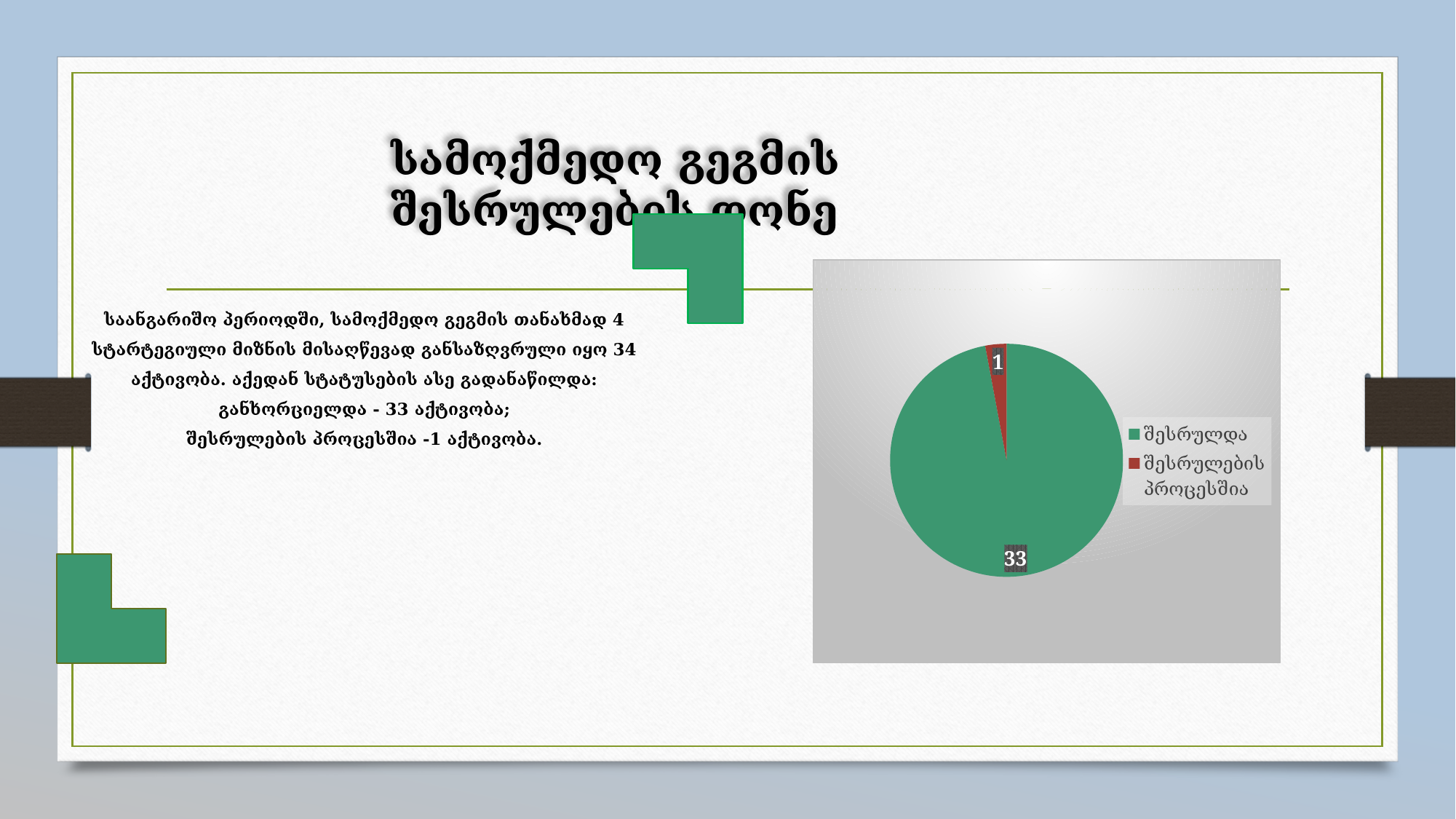
What is the value for the შესრულების პროცესშია slice of the pie chart? 1 How many slices does the pie chart have? 2 Which slice of the pie chart is the largest? შესრულდა Which slice of the pie chart is the smallest? შესრულების პროცესშია Which is larger in the pie chart, შესრულდა or შესრულების პროცესშია? შესრულდა What is the value for the შესრულდა slice of the pie chart? 33 How many entries does the legend of the pie chart list? 2 What kind of chart is shown on the slide? pie chart What colour is the შესრულების პროცესშია slice in the pie chart? red What is the total of all slices in the pie chart? 34 What colour is the შესრულდა slice in the pie chart? green What is the difference between the შესრულდა and შესრულების პროცესშია values in the pie chart? 32